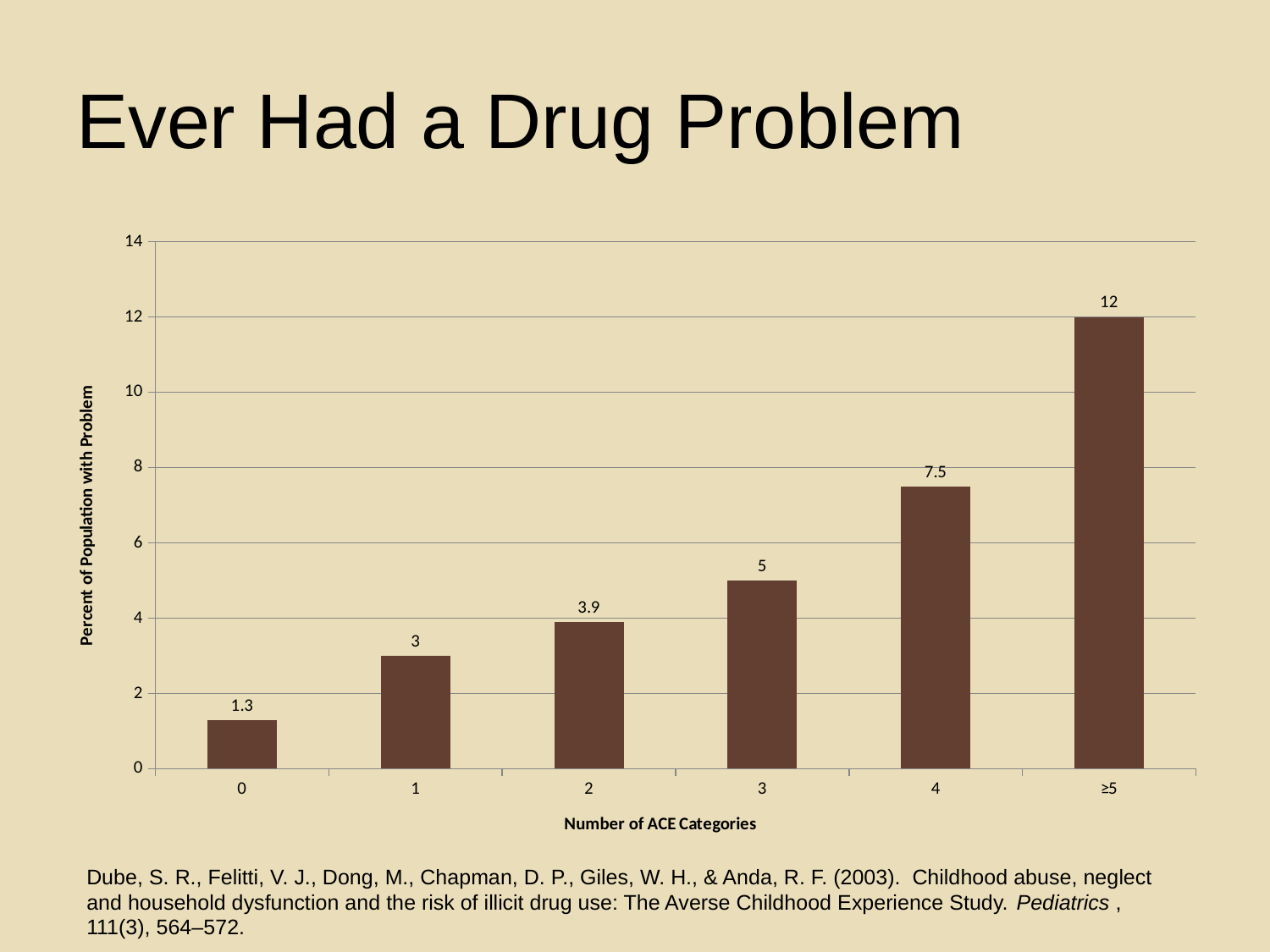
Is the value for ≥5 ACE categories greater or less than 10? greater What is the difference between the values for 3 and 1 ACE categories? 2 What is the percent of population with a drug problem for 0 ACE categories? 1.3 What kind of chart is shown on the slide? bar chart What is the difference between the values for ≥5 and 4 ACE categories? 4.5 Which number of ACE categories has the highest percent of population with a drug problem? ≥5 What is the value for 4 ACE categories? 7.5 What is the value for 2 ACE categories? 3.9 Which number of ACE categories has the lowest percent of population with a drug problem? 0 How many ACE category groups are shown on the x axis? 6 Which is larger, the value for 2 ACE categories or the value for 3 ACE categories? 3 ACE categories Do the values rise or fall as the number of ACE categories increases? rise